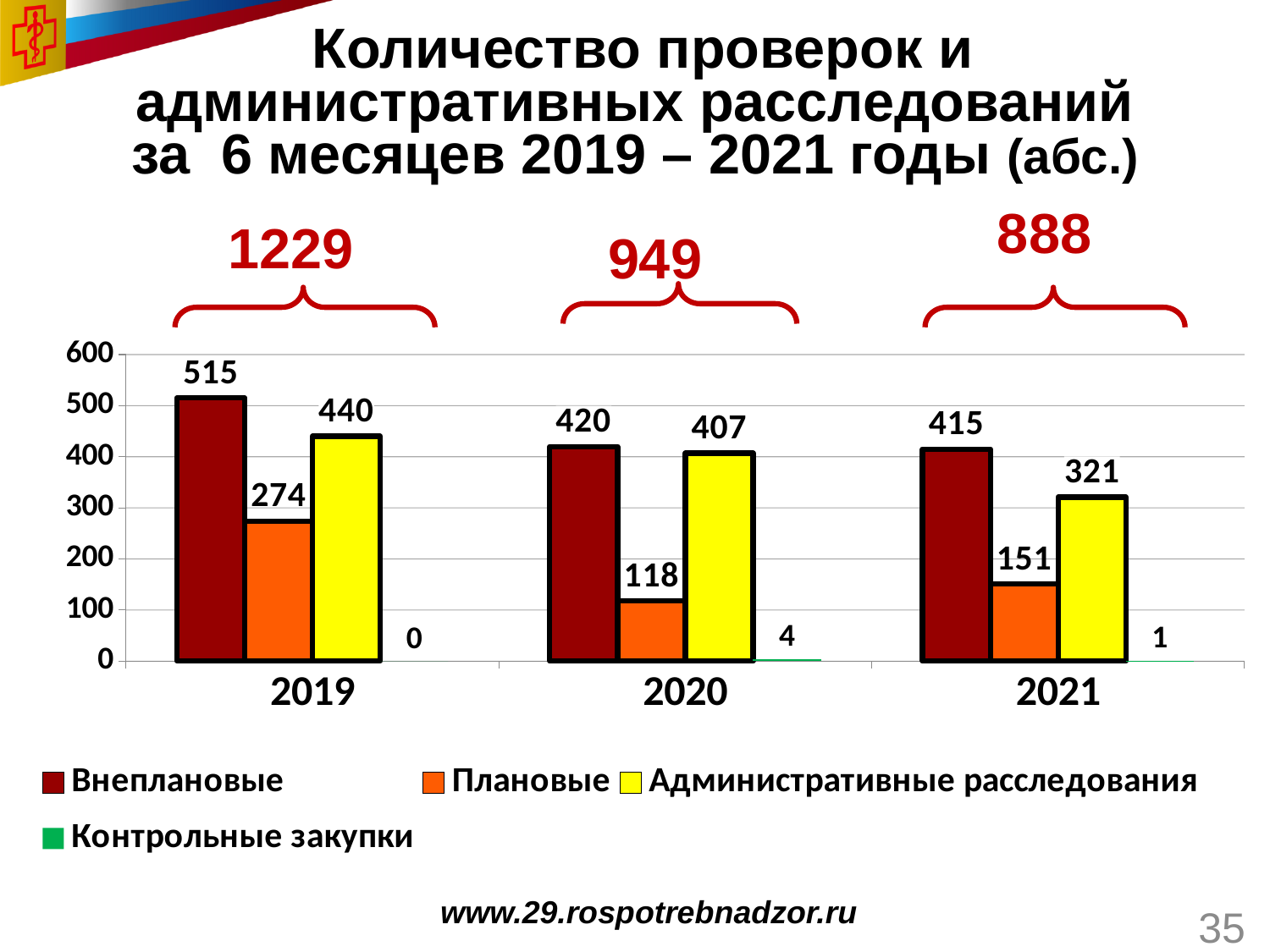
What total is shown above the bracket for 2020? 949 What is the value for Административные расследования in 2021? 321 How many years are shown on the x axis? 3 What is the value for Контрольные закупки in 2020? 4 What is the value for Внеплановые in 2019? 515 Which is larger: Внеплановые in 2020 or Внеплановые in 2021? Внеплановые in 2020 What is the difference between Административные расследования in 2019 and in 2021? 119 In which year is the value for Внеплановые highest? 2019 In which year is the value for Плановые lowest? 2020 How many series does the legend list? 4 What is the value for Плановые in 2020? 118 What kind of chart is shown on the slide? bar chart